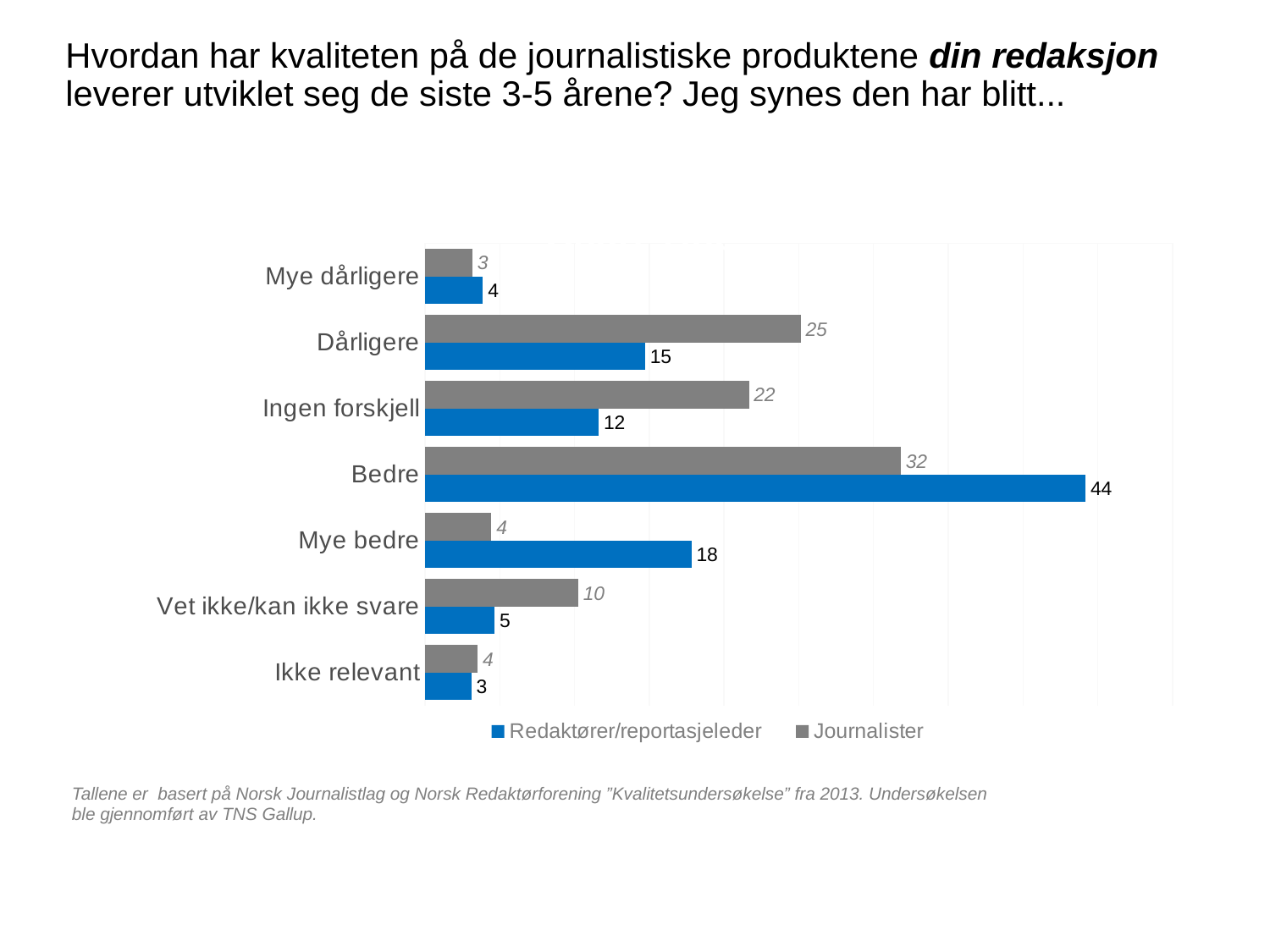
Which colour represents the Journalister series? Grey What kind of chart is shown on the slide? Bar chart Which category has the lowest value for Redaktører/reportasjeleder? Ikke relevant What is the value for Redaktører/reportasjeleder in the Bedre category? 44 What is the value for Journalister in the Dårligere category? 25 What is the difference between Redaktører/reportasjeleder and Journalister in the Bedre category? 12 What is the value for Journalister in the Mye bedre category? 4 How many series does the legend list? 2 Which is larger in the Ingen forskjell category: Redaktører/reportasjeleder or Journalister? Journalister What is the value for Redaktører/reportasjeleder in the Vet ikke/kan ikke svare category? 5 Which category has the highest value for Journalister? Bedre How many categories are shown on the chart? 7